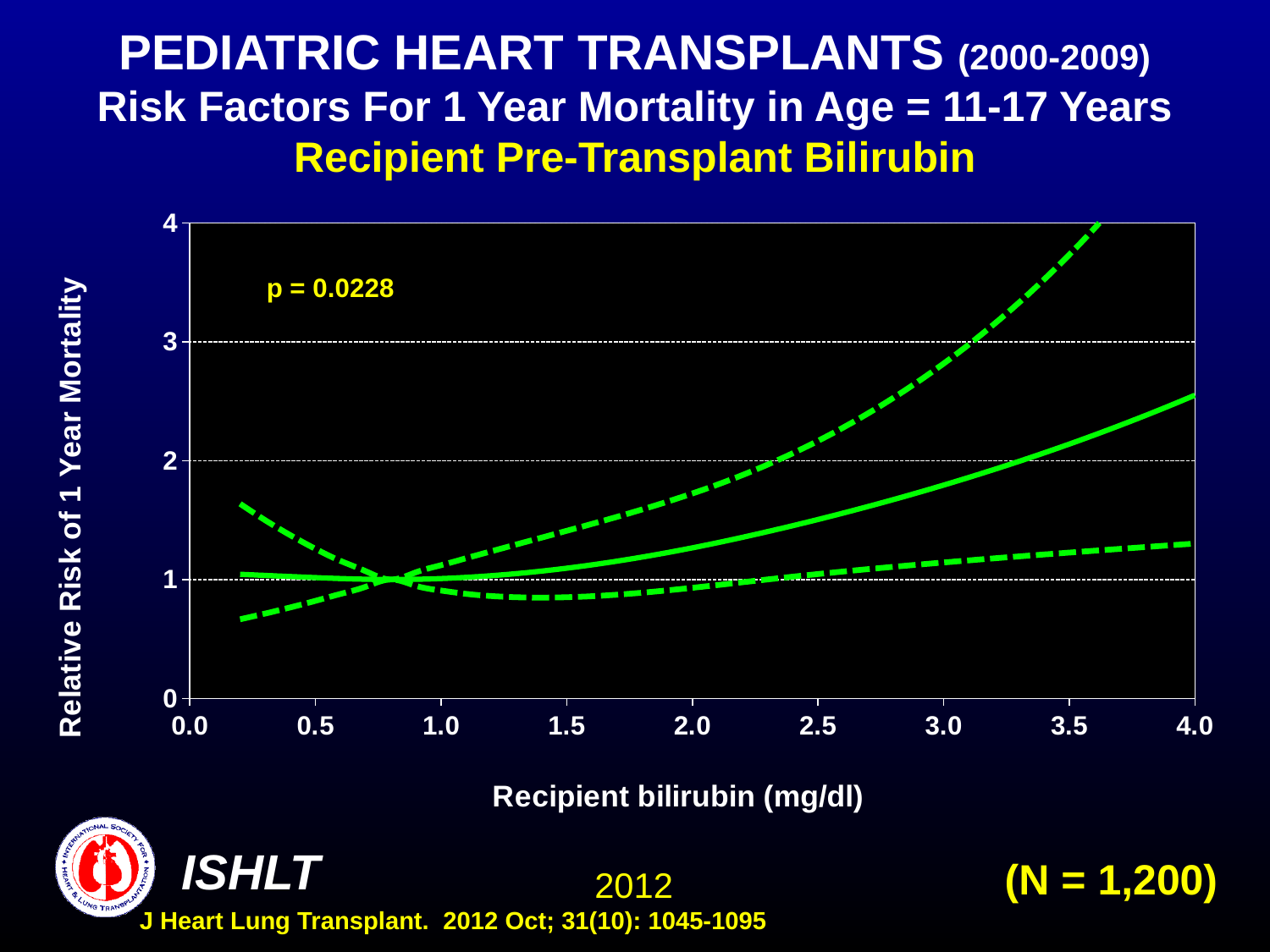
What p-value is printed on the chart? p = 0.0228 How many lines are plotted on the chart? 3 Is the value of the solid line at a recipient bilirubin of 1.0 mg/dl greater or less than 2? less Is the value of the solid line at a recipient bilirubin of 4.0 mg/dl greater or less than 2? greater Is the value of the upper dashed line at a recipient bilirubin of 3.5 mg/dl greater or less than 3? greater At a recipient bilirubin of 3.0 mg/dl, which is larger: the solid line or the lower dashed line? the solid line What is the label of the x axis? Recipient bilirubin (mg/dl) Does the solid line rise or fall as recipient bilirubin increases from 1.0 to 4.0 mg/dl? rise What kind of chart is shown on the slide? line chart